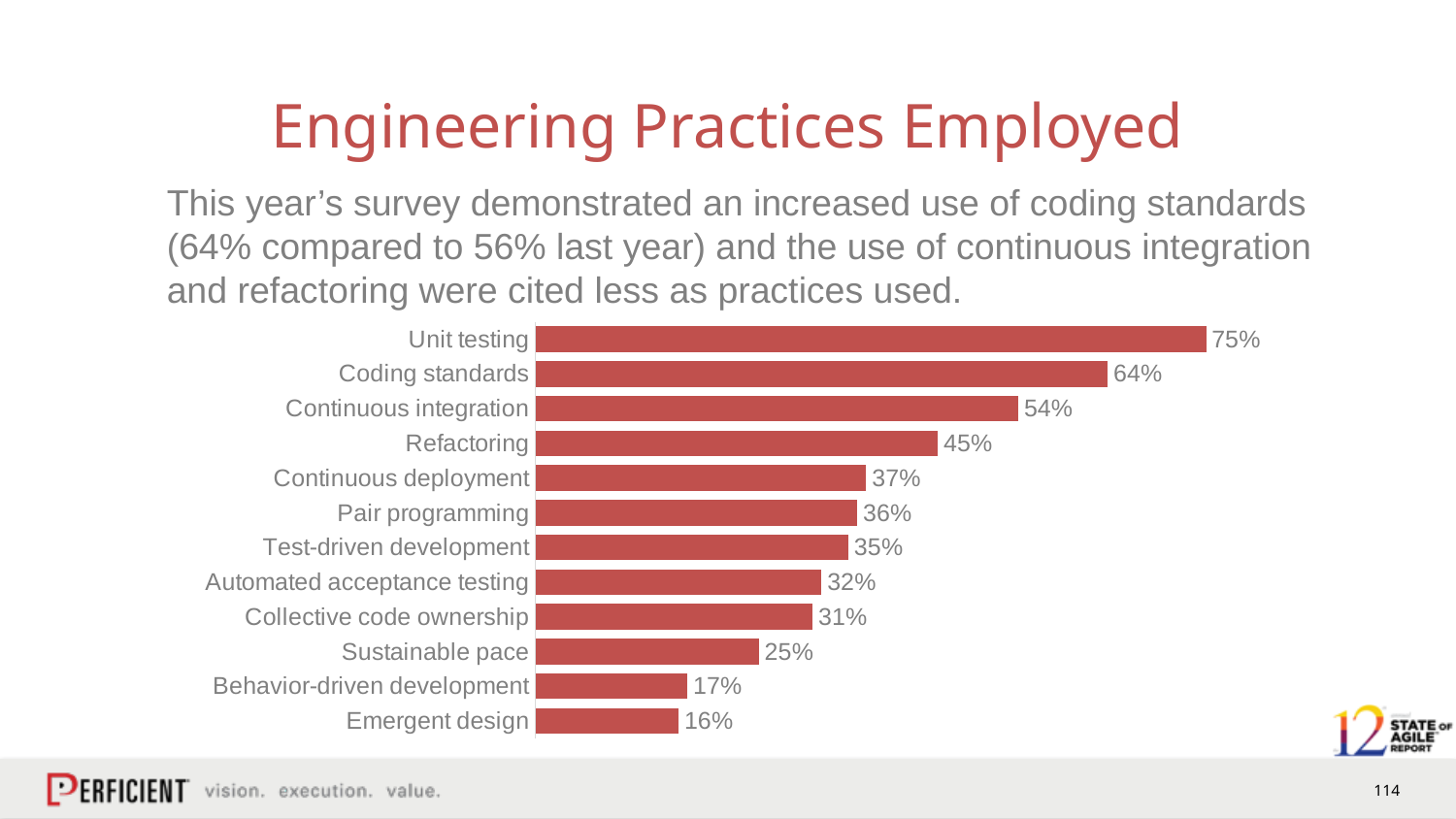
How many engineering practices are listed in the chart? 12 Which has a higher percentage, Behavior-driven development or Sustainable pace? Sustainable pace What is the difference between the percentages for Coding standards and Continuous integration? 10% What is the difference between the percentages for Refactoring and Emergent design? 29% What percentage is shown for Unit testing? 75% What percentage is shown for Sustainable pace? 25% Which has a higher percentage, Test-driven development or Collective code ownership? Test-driven development What percentage is shown for Pair programming? 36% Which engineering practice has the highest percentage? Unit testing What kind of chart is shown on the slide? Bar chart What is the title of the slide containing the chart? Engineering Practices Employed Which engineering practice has the lowest percentage? Emergent design